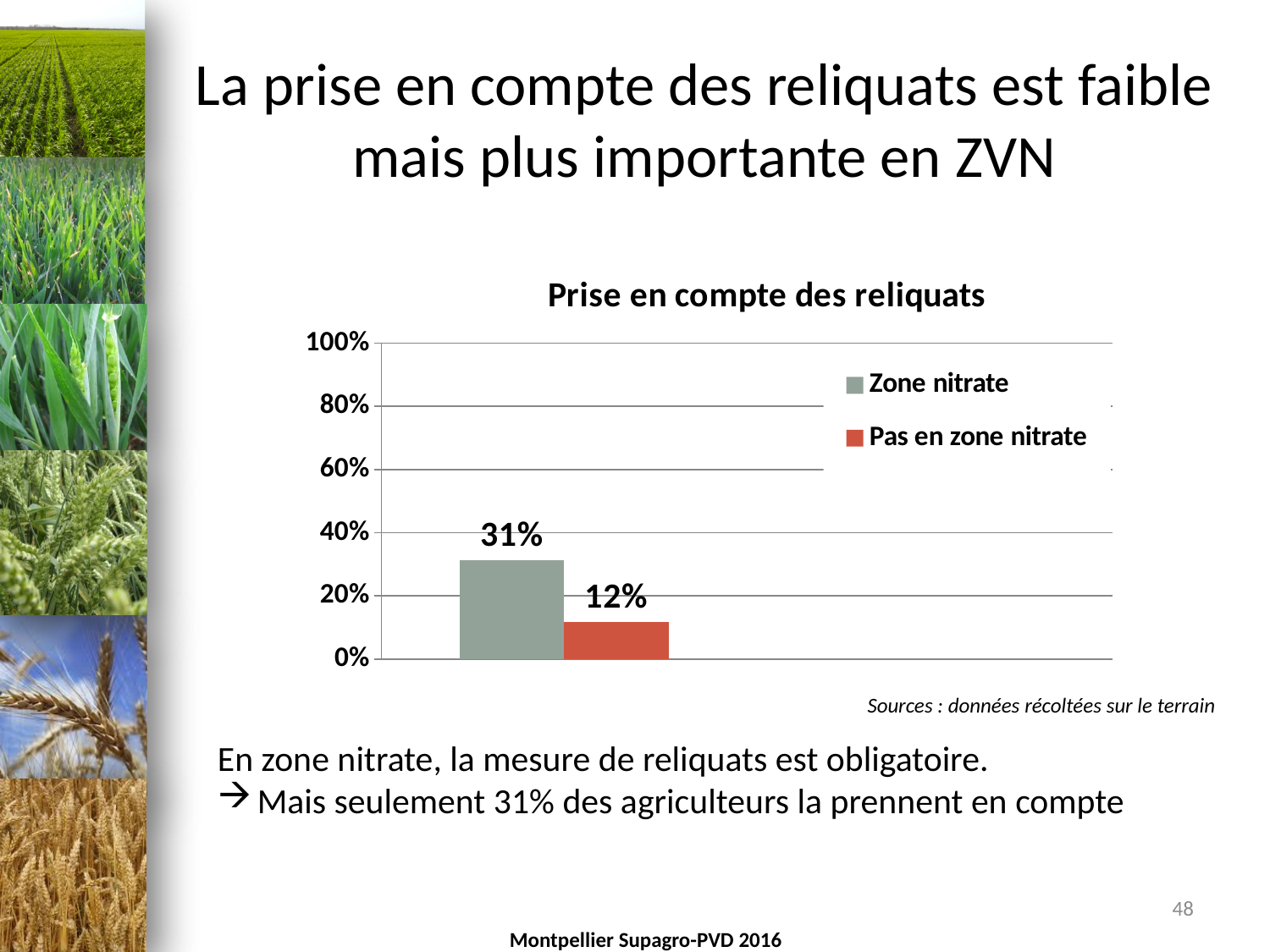
Which series has the lowest value? Pas en zone nitrate What is the value for Zone nitrate? 31% What is the value for Pas en zone nitrate? 12% How many series does the legend list? 2 Is the value for Pas en zone nitrate greater or less than 20%? less Which is larger, the value for Zone nitrate or the value for Pas en zone nitrate? Zone nitrate What is the title of the chart? Prise en compte des reliquats What is the highest value shown on the vertical axis of the chart? 100% Which series has the highest value? Zone nitrate Is the value for Zone nitrate greater or less than 40%? less What is the difference between the Zone nitrate value and the Pas en zone nitrate value? 19% What kind of chart is shown on the slide? bar chart